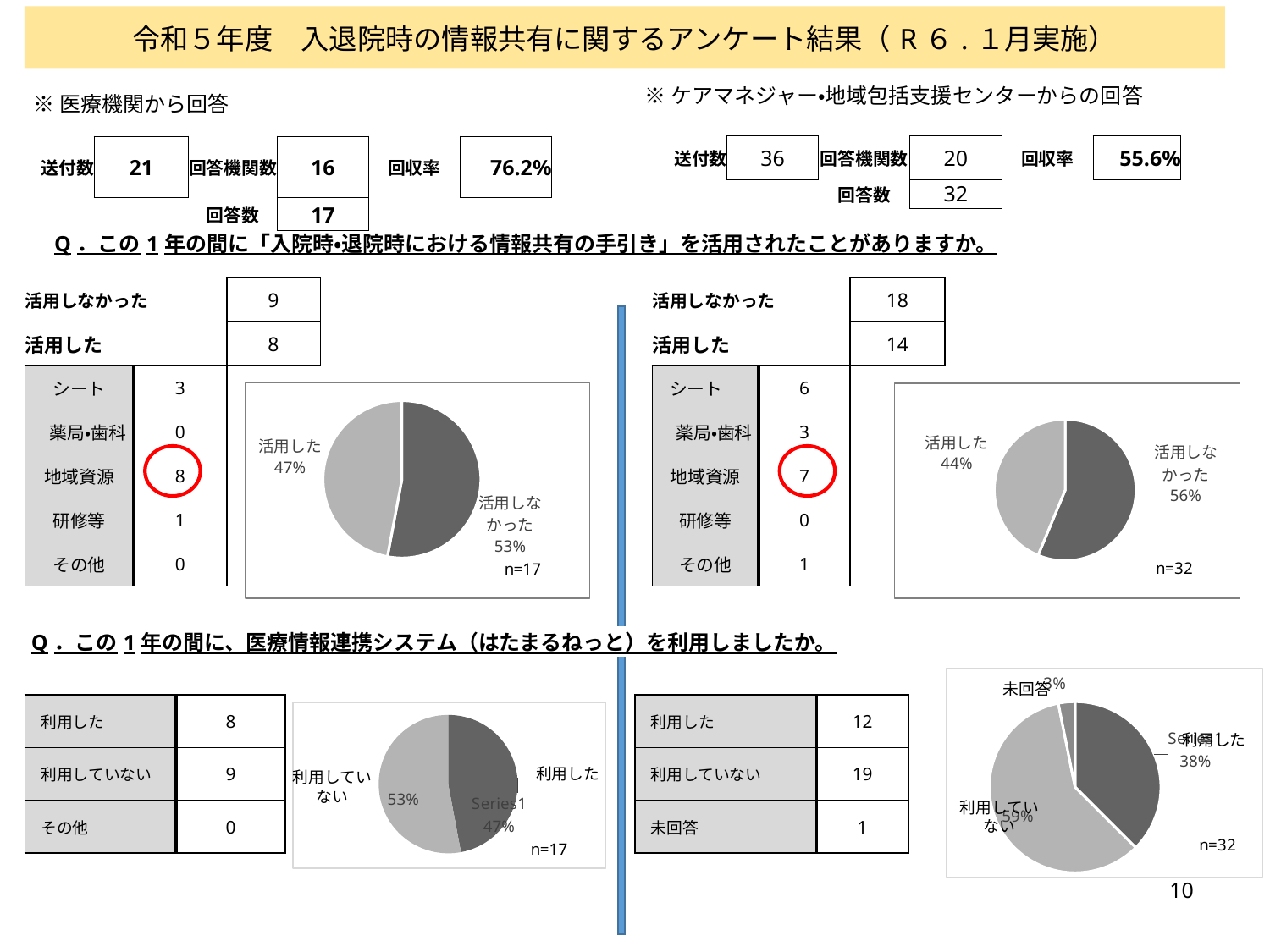
In the top-left pie chart (医療機関, 手引き活用), what percentage is shown for 活用しなかった? 53% In the top-right pie chart (ケアマネジャー, 手引き活用), what percentage is shown for 活用しなかった? 56% In the bottom-right pie chart (ケアマネジャー, はたまるねっと), what percentage is shown for 利用した? 38% In the top-left pie chart (医療機関, 手引き活用), what percentage is shown for 活用した? 47% How many slices does the bottom-right pie chart (ケアマネジャー, はたまるねっと) have? 3 In the bottom-right pie chart (ケアマネジャー, はたまるねっと), which slice is the largest? 利用していない In the bottom-left pie chart (医療機関, はたまるねっと), what percentage is shown for 利用した? 47% In the top-right pie chart (ケアマネジャー, 手引き活用), what is the difference in percentage points between 活用しなかった and 活用した? 12 In the top-right pie chart (ケアマネジャー, 手引き活用), what percentage is shown for 活用した? 44% In the bottom-left pie chart (医療機関, はたまるねっと), what percentage is shown for 利用していない? 53% In the top-left pie chart (医療機関, 手引き活用), which slice is larger, 活用した or 活用しなかった? 活用しなかった What is the n value shown in the top-right pie chart (ケアマネジャー, 手引き活用)? n=32